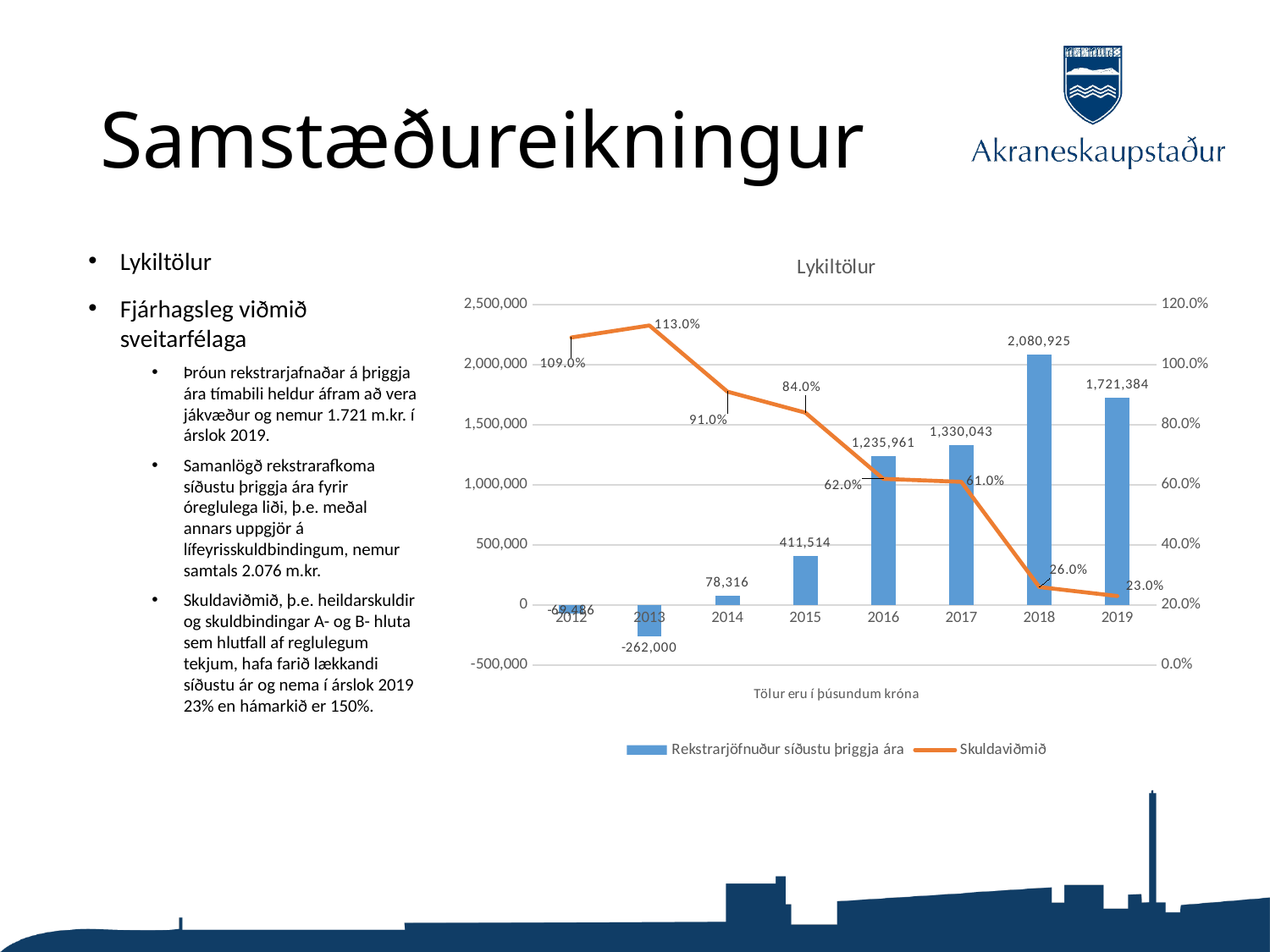
Which is larger, the Rekstrarjöfnuður síðustu þriggja ára value for 2016 or for 2017? 2017 What is the Skuldaviðmið value for 2019? 23.0% What is the Skuldaviðmið value for 2013? 113.0% Does the Skuldaviðmið line generally rise or fall from 2013 to 2019? fall What is the title of the chart? Lykiltölur How many series does the chart legend list? 2 What is the value of Rekstrarjöfnuður síðustu þriggja ára for 2018? 2,080,925 Which year has the highest Rekstrarjöfnuður síðustu þriggja ára? 2018 How many years are shown on the x axis of the chart? 8 What is the difference between the Rekstrarjöfnuður síðustu þriggja ára values for 2018 and 2019? 359,541 Which year has the lowest Skuldaviðmið value? 2019 What is the value of Rekstrarjöfnuður síðustu þriggja ára for 2013? -262,000